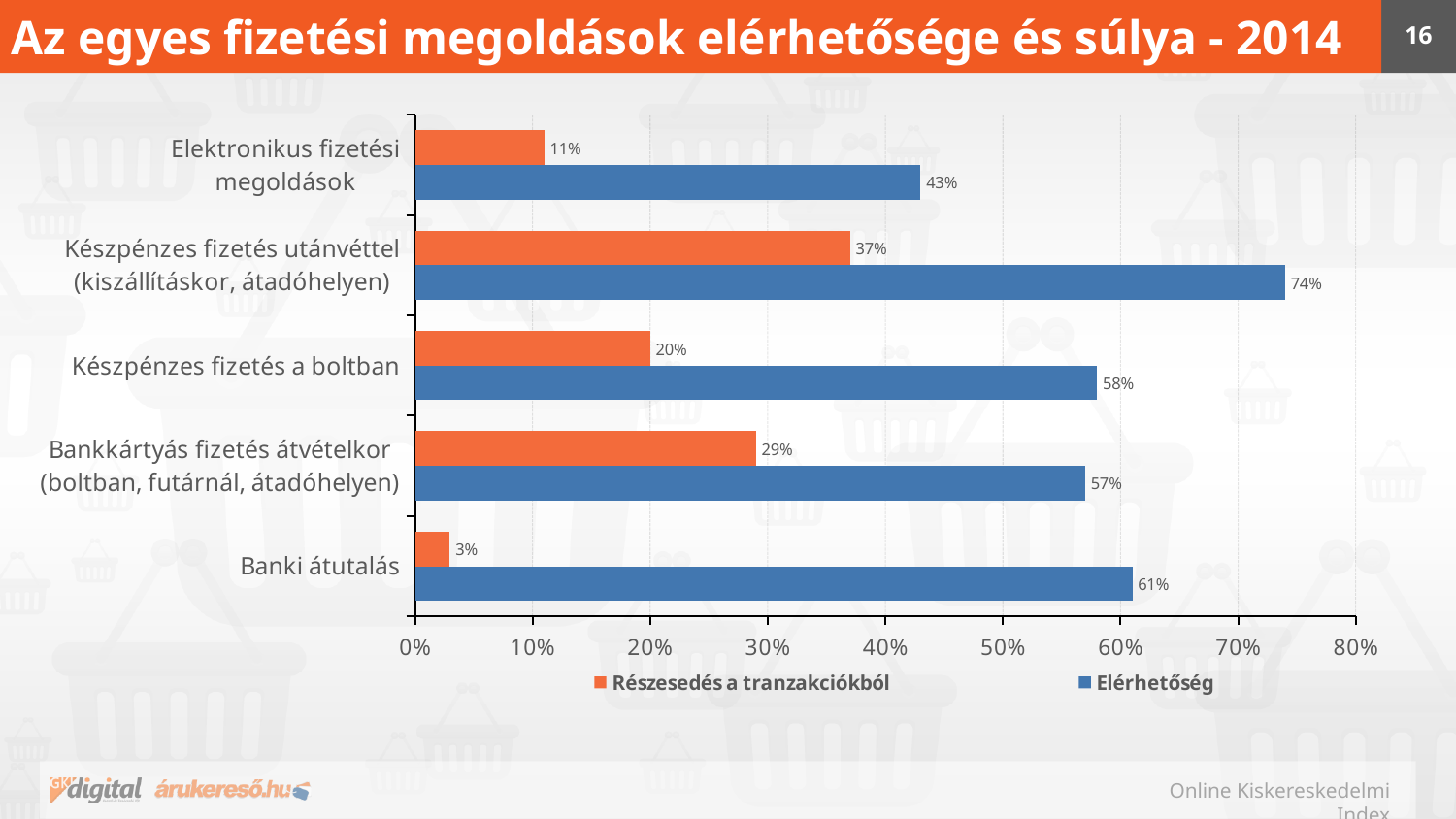
Which colour represents the Elérhetőség series? blue What is the difference between the Elérhetőség and Részesedés a tranzakciókból values for Készpénzes fizetés a boltban? 38% What kind of chart is shown on the slide? bar chart Which category has the highest Elérhetőség value? Készpénzes fizetés utánvéttel (kiszállításkor, átadóhelyen) What is the Részesedés a tranzakciókból value for Banki átutalás? 3% Is the Elérhetőség value for Elektronikus fizetési megoldások greater or less than 50%? less What is the Elérhetőség value for Készpénzes fizetés utánvéttel (kiszállításkor, átadóhelyen)? 74% What is the Részesedés a tranzakciókból value for Bankkártyás fizetés átvételkor (boltban, futárnál, átadóhelyen)? 29% How many categories are shown on the chart? 5 Which category has the lowest Részesedés a tranzakciókból value? Banki átutalás How many series does the legend list? 2 Which is larger: the Elérhetőség value for Banki átutalás or for Elektronikus fizetési megoldások? Banki átutalás